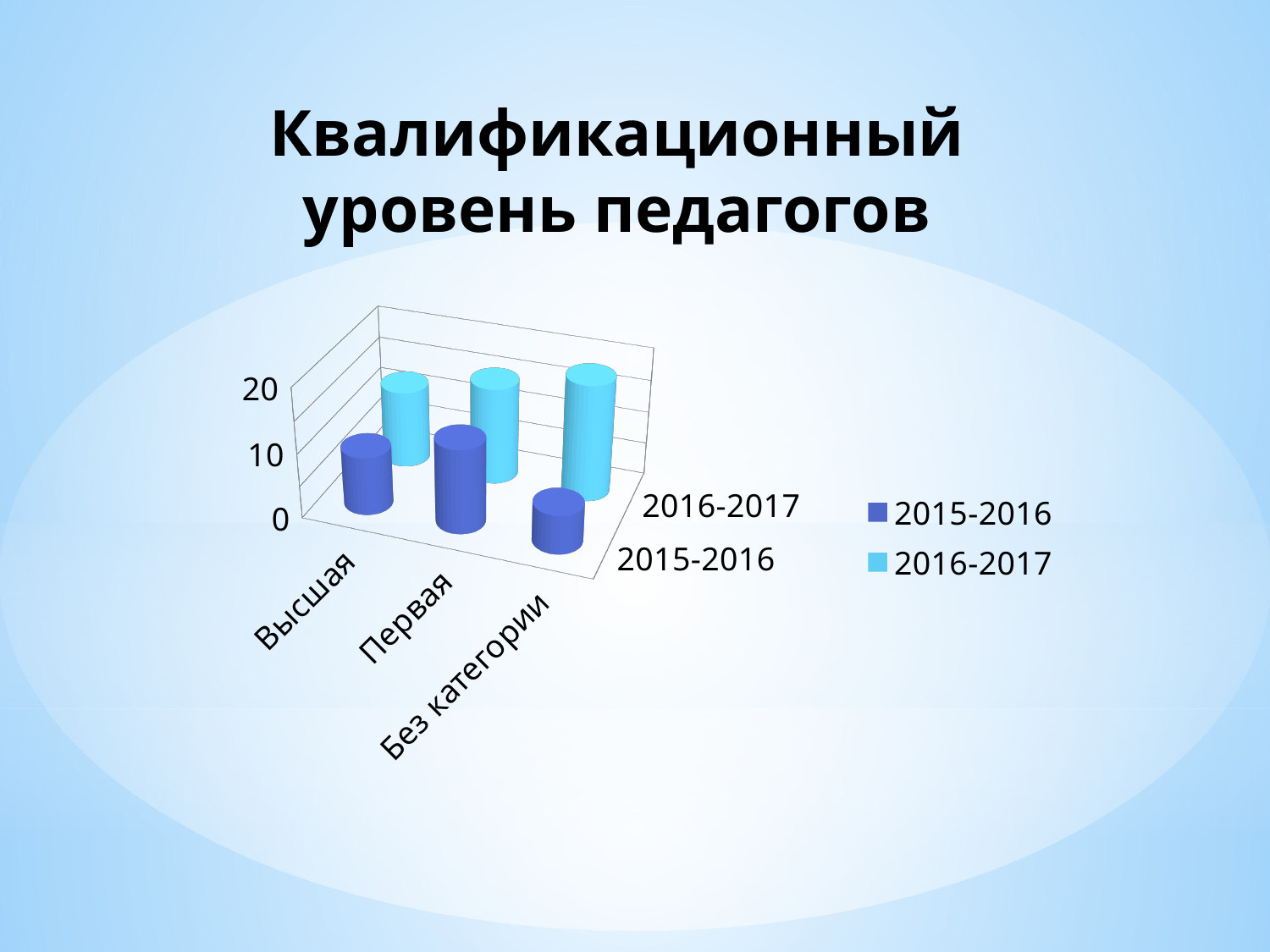
What is the title of the chart? Квалификационный уровень педагогов What kind of chart is shown on the slide? bar chart Do the values in the 2016-2017 series rise or fall from Высшая to Без категории? rise Which category has the highest value in the 2016-2017 series? Без категории For Высшая, which series has the larger value, 2015-2016 or 2016-2017? 2016-2017 Which category has the lowest value in the 2015-2016 series? Без категории How many categories are shown on the x axis? 3 Which category has the highest value in the 2015-2016 series? Первая For Без категории, which series has the larger value, 2015-2016 or 2016-2017? 2016-2017 How many series does the legend list? 2 Is the value for Без категории in the 2015-2016 series greater or less than 10? less Which series are listed in the legend? 2015-2016 and 2016-2017